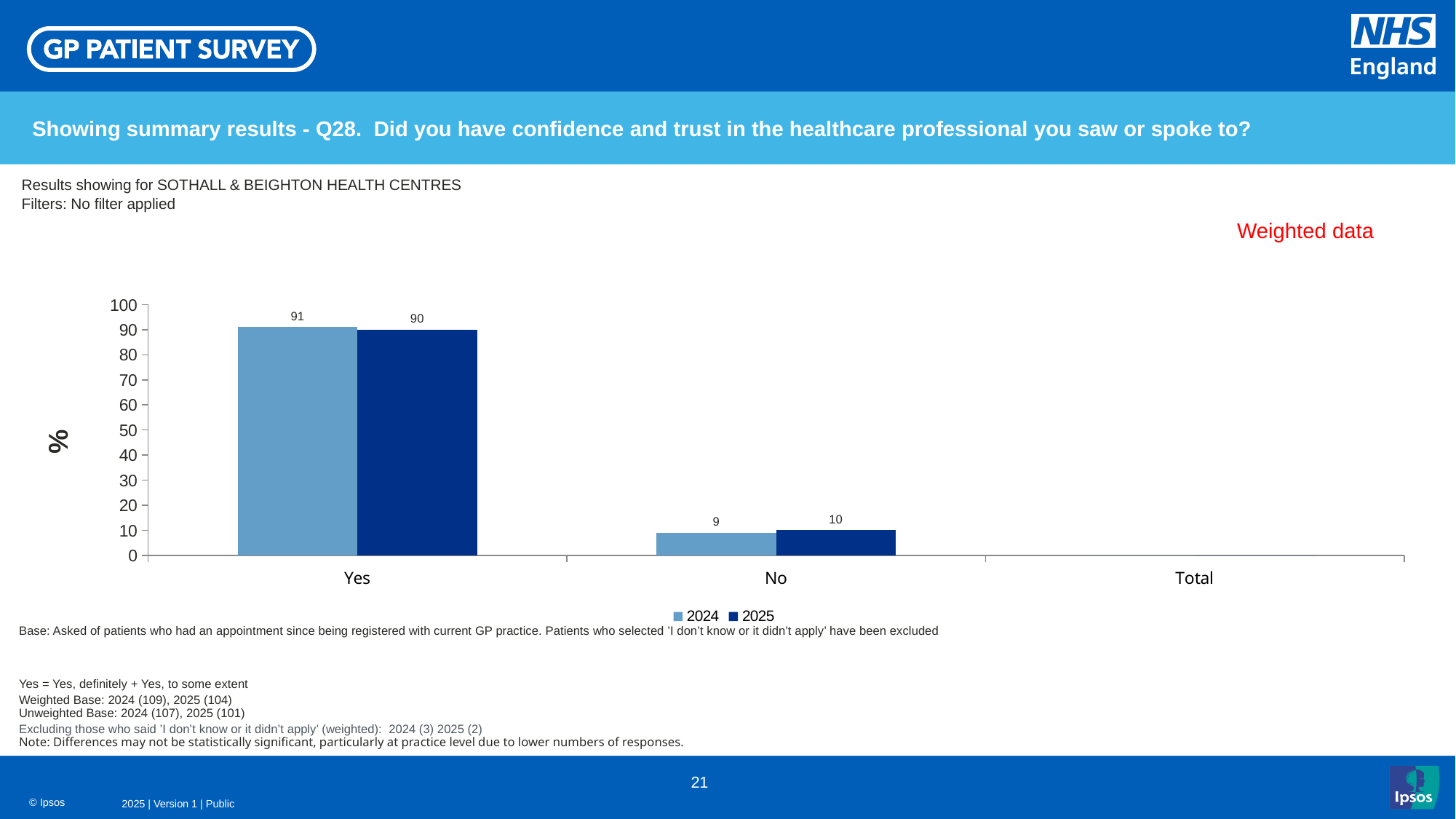
What is the value for No in 2024? 9 What kind of chart is shown on the slide? Bar chart What is the difference between the 2024 and 2025 values for Yes? 1 What is the value for Yes in 2024? 91 Which is larger, the 2024 value for Yes or the 2024 value for No? 2024 value for Yes Which category has the lowest value for 2024? No How many series does the legend list? 2 What is the value for No in 2025? 10 What is the value for Yes in 2025? 90 Which years are listed in the legend? 2024 and 2025 Which category has the highest value for 2025? Yes What is the label on the vertical axis? %